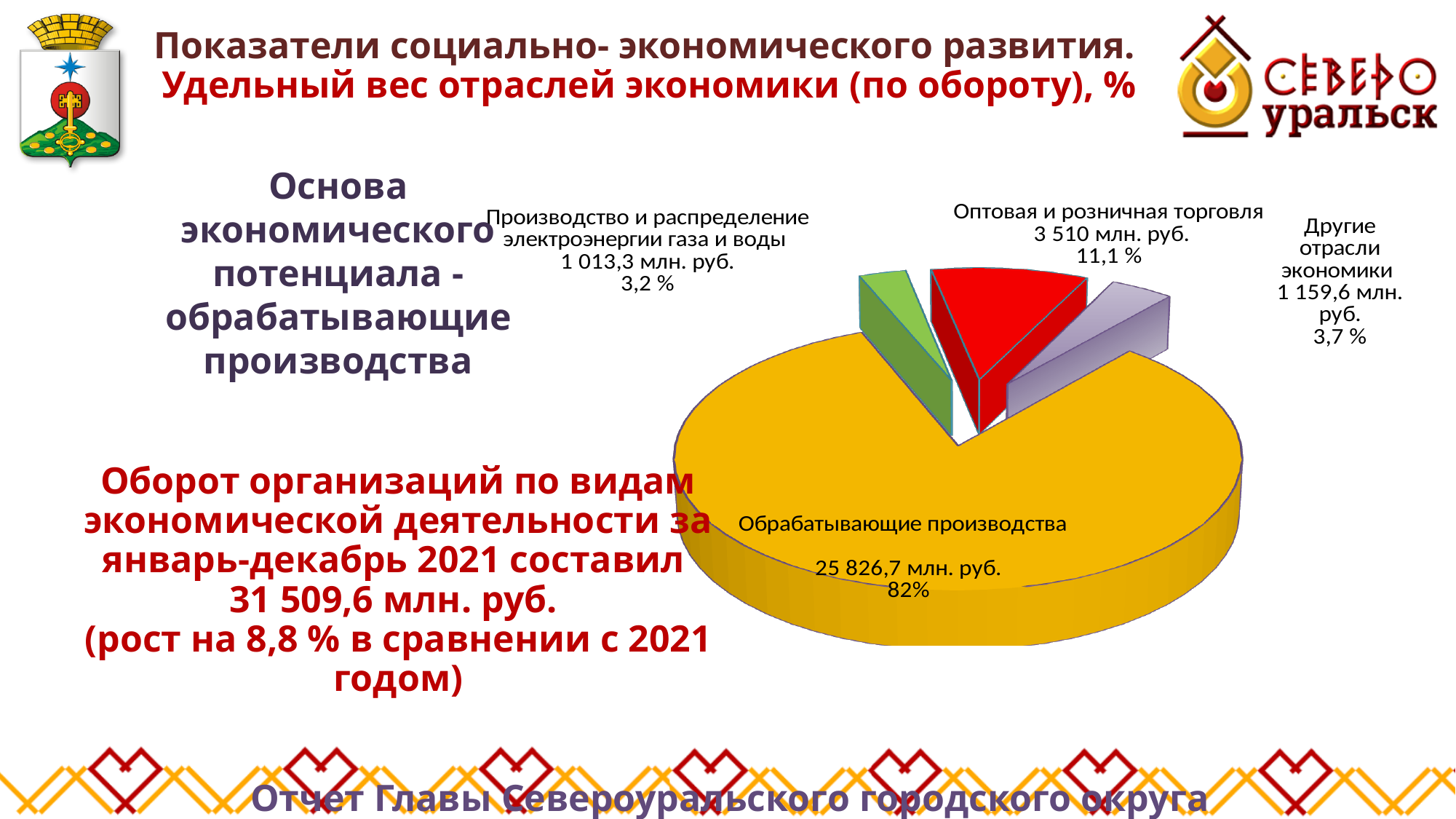
Which slice of the pie chart is the largest? Обрабатывающие производства What percentage is shown for Оптовая и розничная торговля? 11,1 % What is the value for Другие отрасли экономики? 1 159,6 млн. руб. What share of the pie does Обрабатывающие производства hold? 82% What is the value for Обрабатывающие производства in the pie chart? 25 826,7 млн. руб. What percentage is shown for Производство и распределение электроэнергии газа и воды? 3,2 % What colour is the Обрабатывающие производства slice? yellow Which is larger: Оптовая и розничная торговля or Другие отрасли экономики? Оптовая и розничная торговля How many slices does the pie chart have? 4 What is the value for Оптовая и розничная торговля? 3 510 млн. руб. What kind of chart is shown on the slide? pie chart Which slice of the pie chart is the smallest? Производство и распределение электроэнергии газа и воды